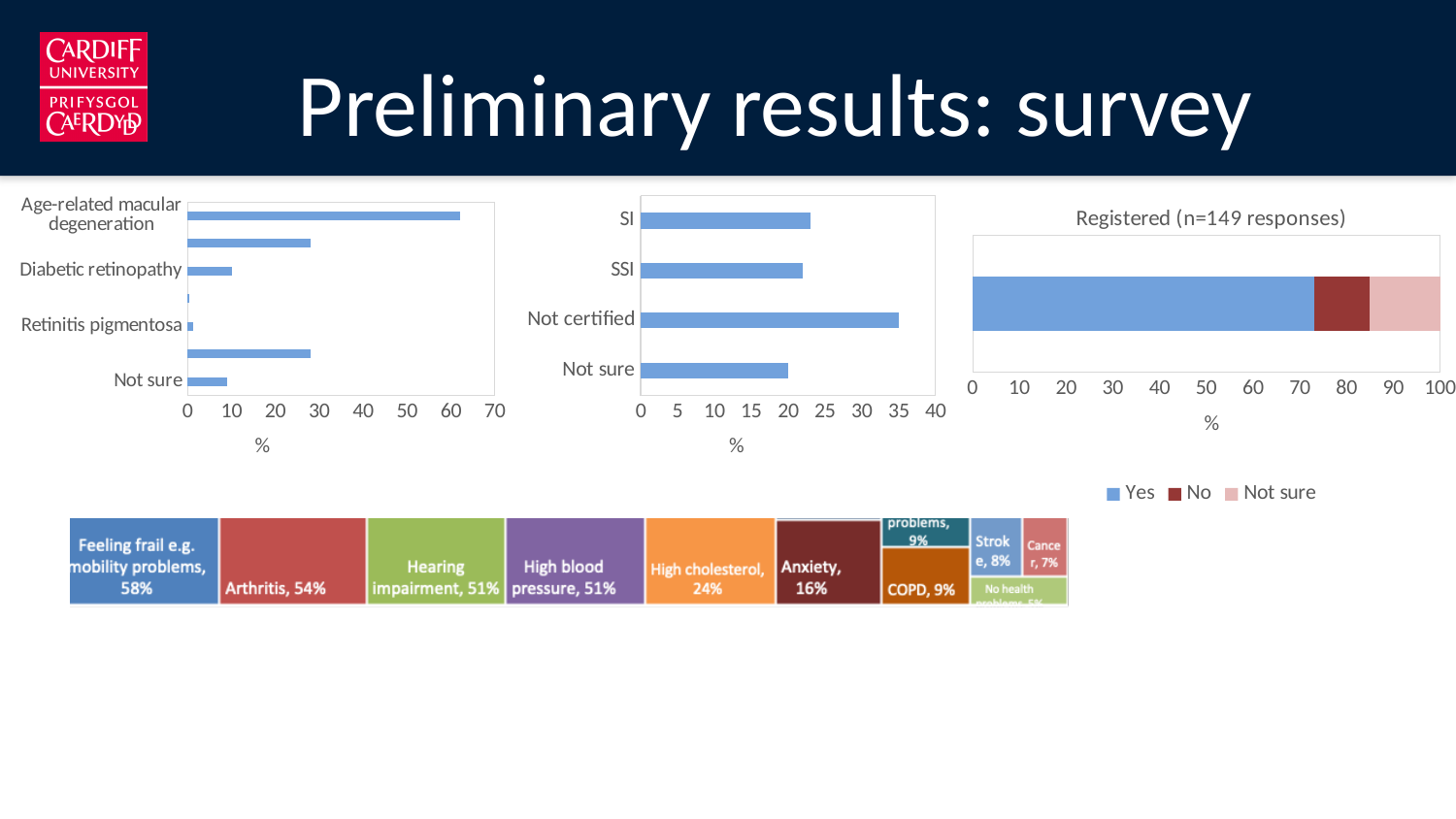
In the middle bar chart, is the value for Not certified greater or less than 30? greater In the left bar chart, is the value for Age-related macular degeneration greater or less than 50? greater What is the title of the chart on the right of the slide? Registered (n=149 responses) In the left bar chart, which category has the highest value? Age-related macular degeneration In the middle bar chart, how many categories are plotted? 4 What kind of chart is the left chart on the slide? bar chart In the treemap at the bottom of the slide, what is the value shown for Arthritis? 54% In the 'Registered (n=149 responses)' chart, how many series does the legend list? 3 In the 'Registered (n=149 responses)' chart, is the value for Yes greater or less than 50? greater In the middle bar chart, which category has the highest value? Not certified In the middle bar chart, which is larger, the value for Not certified or the value for SI? Not certified